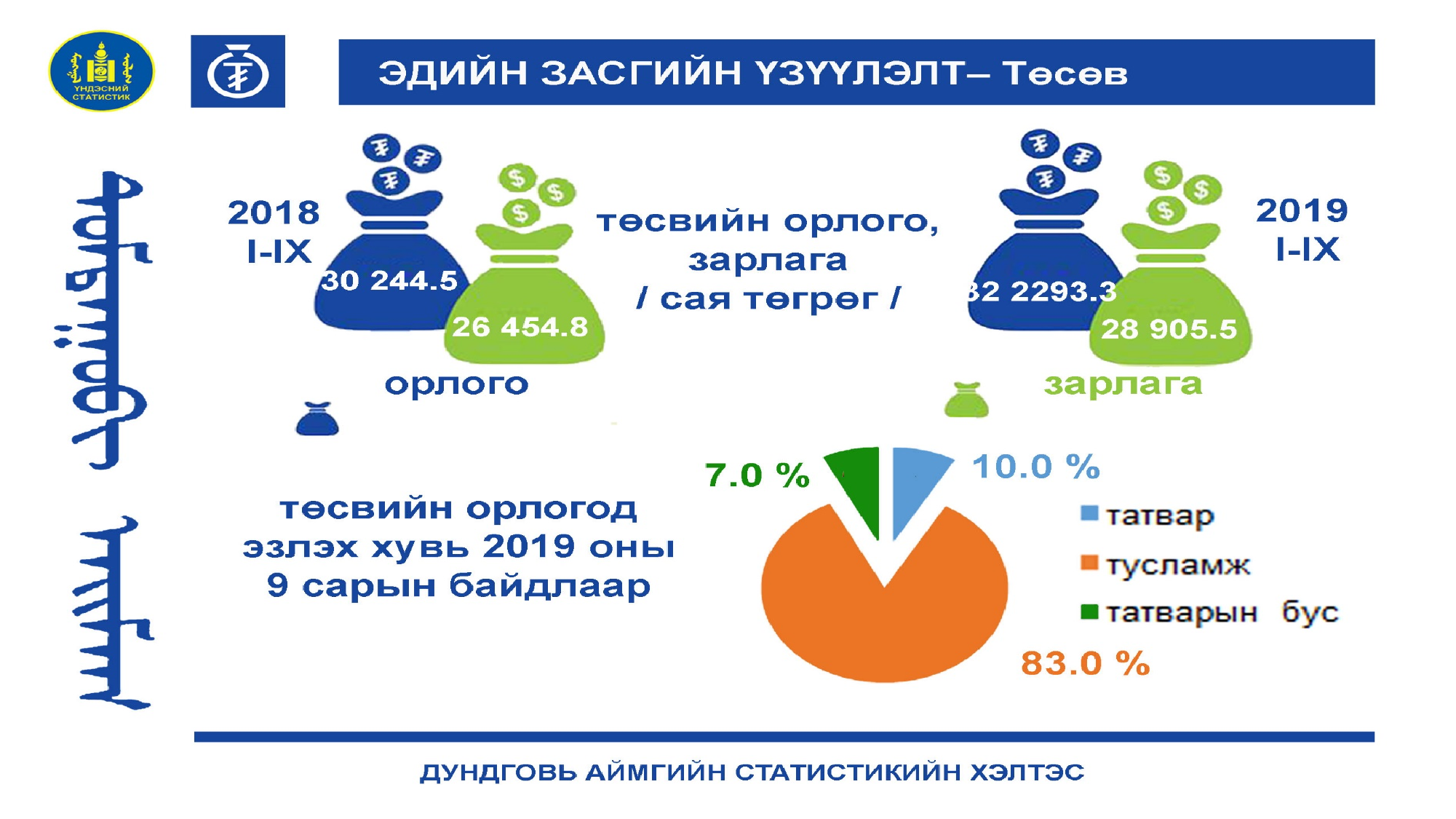
Which category has the smallest slice in the pie chart? татварын бус How many entries does the pie chart legend list? 3 In the pie chart, what share is labelled for татвар? 10.0 % What kind of chart is shown at the bottom right of the slide? pie chart Which category has the largest slice in the pie chart? тусламж In the pie chart, what share is labelled for тусламж? 83.0 % In the money-bag infographic, what is the 2018 I-IX орлого value shown on the blue bag? 30 244.5 In the pie chart, what is the difference in percentage points between the тусламж share and the татвар share? 73.0 % What colour is the тусламж slice in the pie chart? orange In the pie chart, what share is labelled for татварын бус? 7.0 % In the pie chart, which is larger: the share for татвар or the share for татварын бус? татвар How many slices does the pie chart have? 3